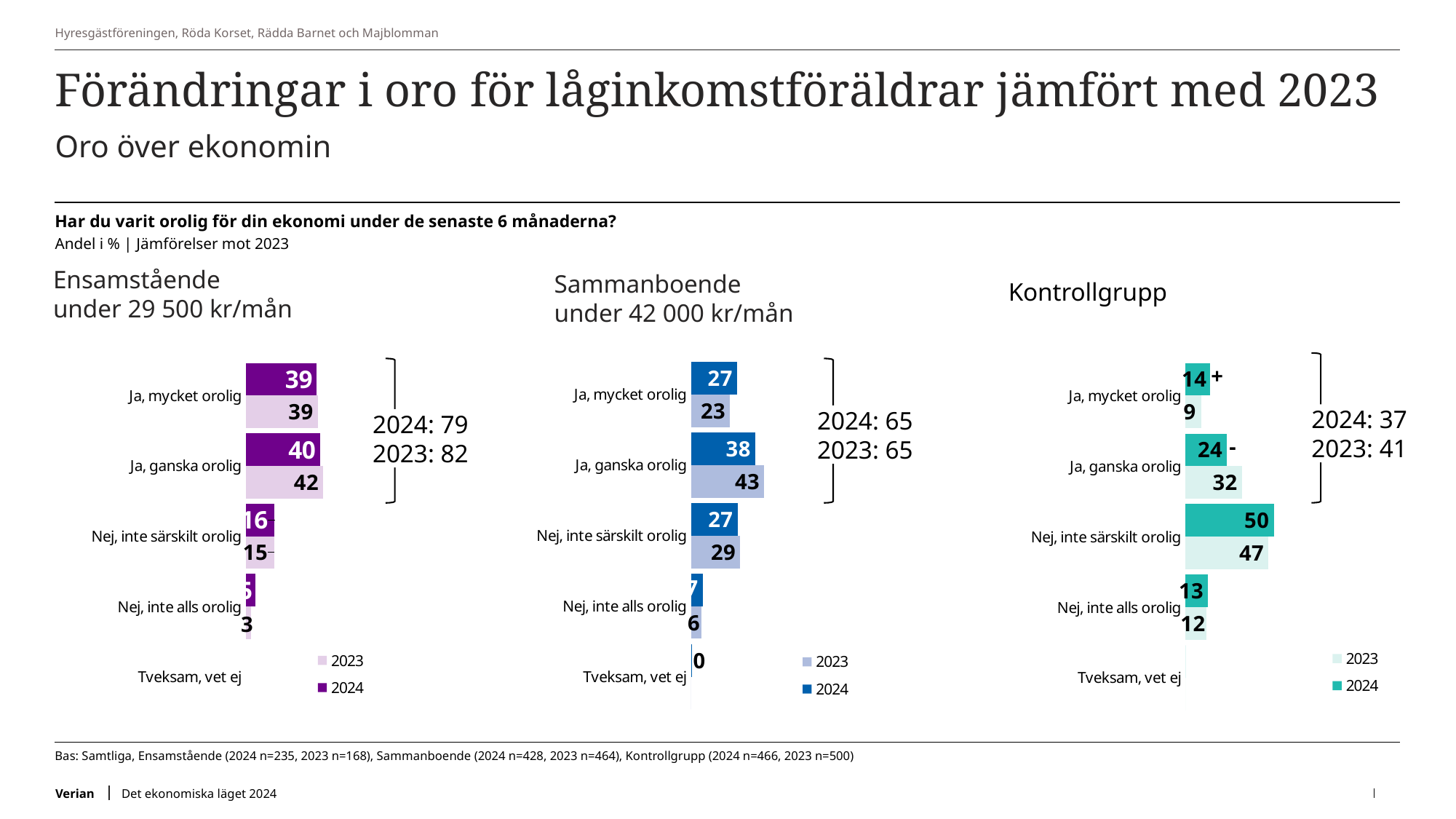
In the Ensamstående under 29 500 kr/mån chart, what is the 2024 value for "Ja, ganska orolig"? 40 In the Kontrollgrupp chart, what is the difference between the 2023 and 2024 values for "Ja, ganska orolig"? 8 In the Kontrollgrupp chart, which category has the highest 2023 value? Nej, inte särskilt orolig In the Ensamstående under 29 500 kr/mån chart, what is the 2023 value for "Nej, inte särskilt orolig"? 15 In the Sammanboende under 42 000 kr/mån chart, what is the 2024 value for "Nej, inte alls orolig"? 7 In the Sammanboende under 42 000 kr/mån chart, what is the 2023 value for "Ja, ganska orolig"? 43 In the Kontrollgrupp chart, what is the 2024 value for "Nej, inte särskilt orolig"? 50 What kind of chart is the Kontrollgrupp chart? bar chart How many charts are shown on the slide? 3 In the Sammanboende under 42 000 kr/mån chart, is the 2024 value for "Ja, mycket orolig" larger or smaller than the 2023 value? larger How many series does the legend list in the Ensamstående under 29 500 kr/mån chart? 2